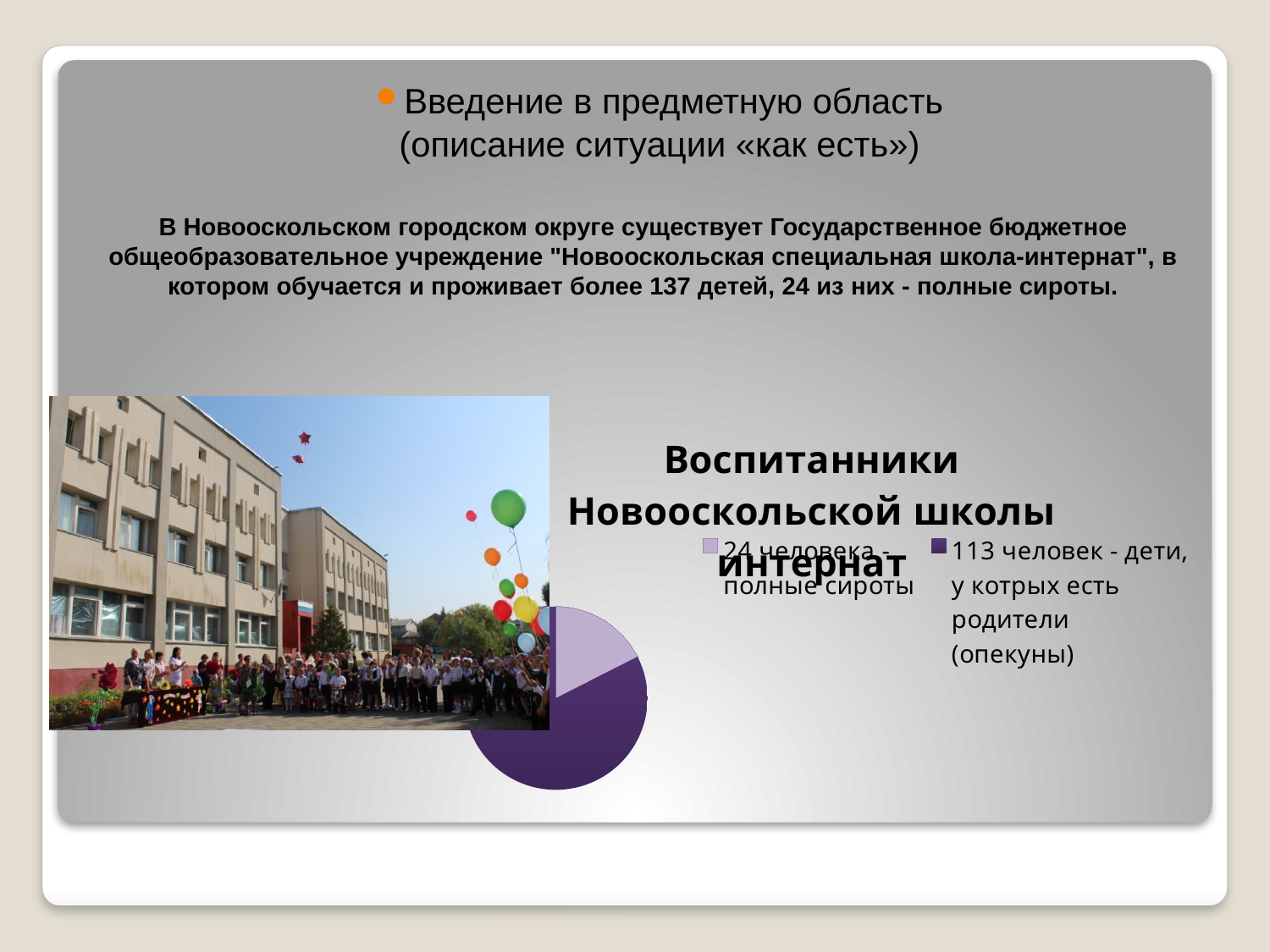
Is the slice for полные сироты larger or smaller than the slice for дети, у которых есть родители (опекуны)? smaller What is the title of the pie chart? Воспитанники Новооскольской школы интернат According to the legend, how many pupils are дети, у которых есть родители (опекуны)? 113 Which category takes the larger share of the pie chart? 113 человек - дети, у котрых есть родители (опекуны) What kind of chart is shown on the slide? pie chart By how many pupils does the group with parents (guardians) exceed the group of полные сироты, using the numbers in the legend? 89 What colour is the slice for 24 человека - полные сироты? light purple How many slices does the pie chart have? 2 Which category takes the smaller share of the pie chart? 24 человека - полные сироты How many entries does the legend of the pie chart list? 2 According to the legend, how many pupils are полные сироты? 24